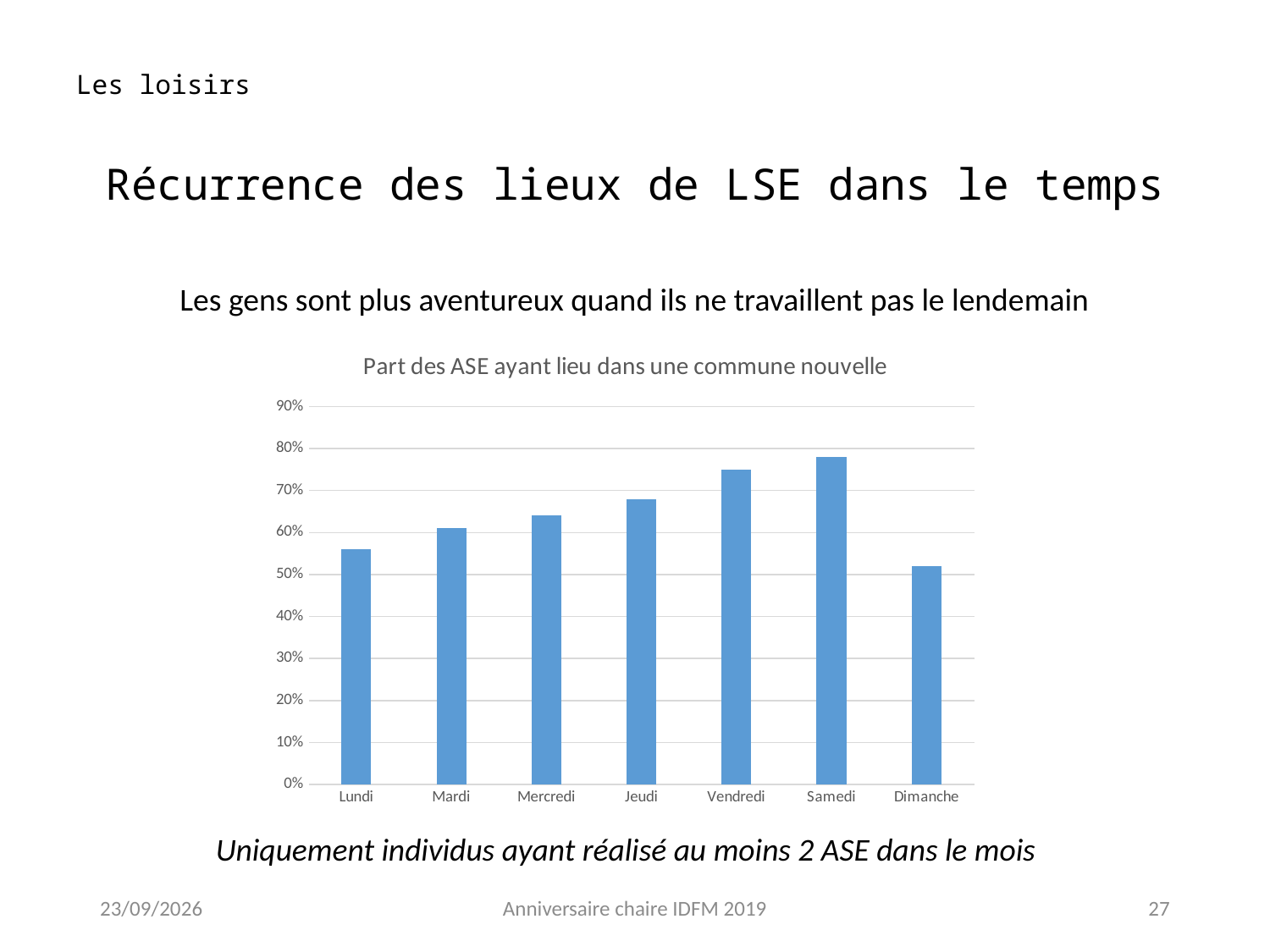
Which day has the highest value in the chart? Samedi Is the value for Lundi greater or less than 60%? less What kind of chart is shown on the slide? bar chart Do the values rise or fall from Lundi to Samedi? rise Which is larger, the value for Jeudi or the value for Mardi? Jeudi How many days (categories) are shown on the x axis of the chart? 7 What is the highest value shown on the y axis of the chart? 90% Is the value for Vendredi greater or less than 70%? greater Which day has the lowest value in the chart? Dimanche What is the title of the chart? Part des ASE ayant lieu dans une commune nouvelle